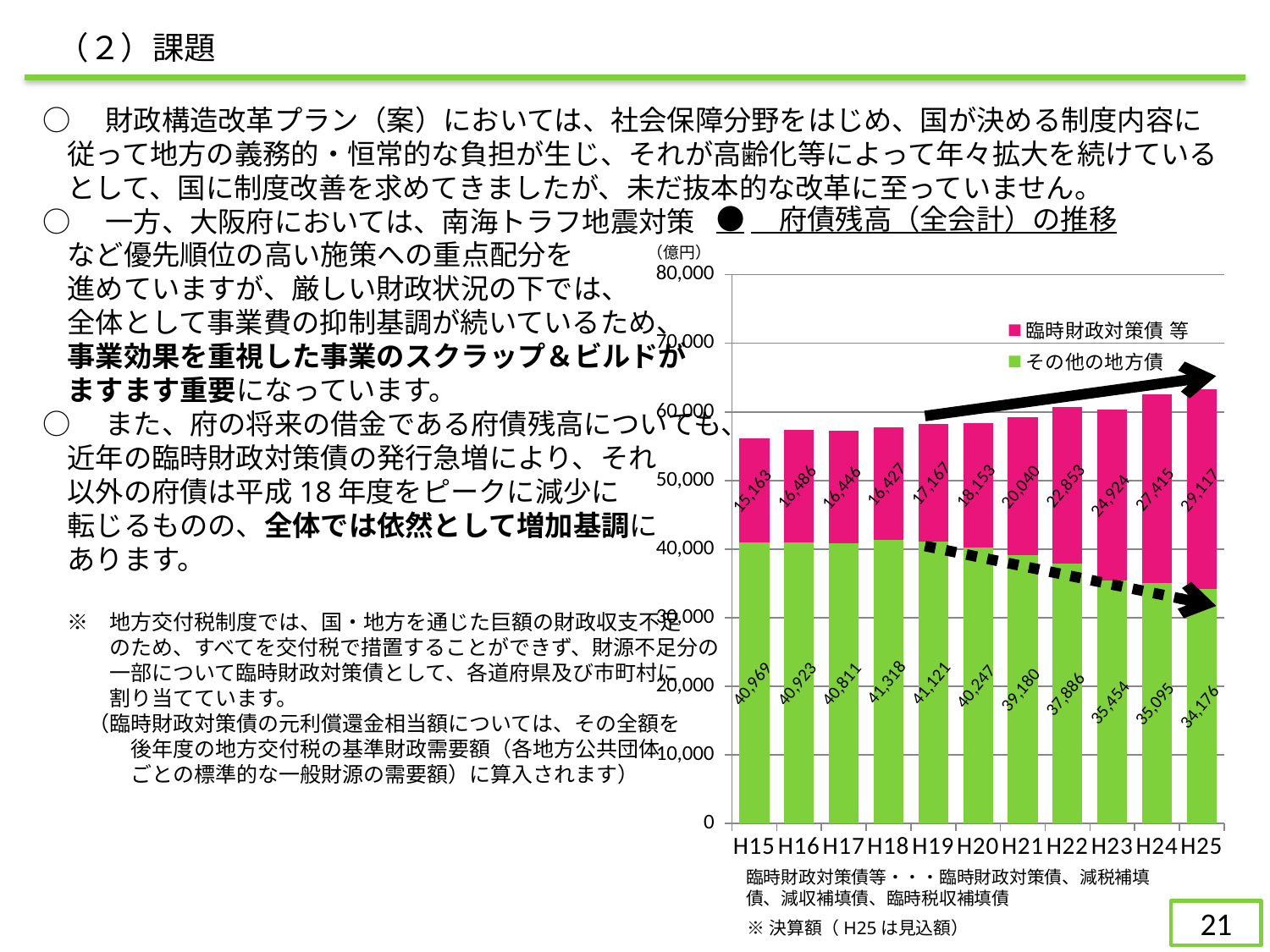
What is the value of その他の地方債 for H18? 41,318 How many fiscal years are plotted on the x axis of the chart? 11 How many series does the legend of the 府債残高（全会計）の推移 chart list? 2 What kind of chart is shown on the slide? Stacked bar chart In which year is その他の地方債 highest? H18 By how much did 臨時財政対策債 等 increase from H15 to H25? 13,954 What is the value of 臨時財政対策債 等 for H25? 29,117 Which is larger, その他の地方債 in H19 or in H25? H19 What is the total of the stacked bar for H25? 63,293 Does 臨時財政対策債 等 rise or fall from H19 to H25? Rise What is the value of 臨時財政対策債 等 for H15? 15,163 In which year is 臨時財政対策債 等 lowest? H15